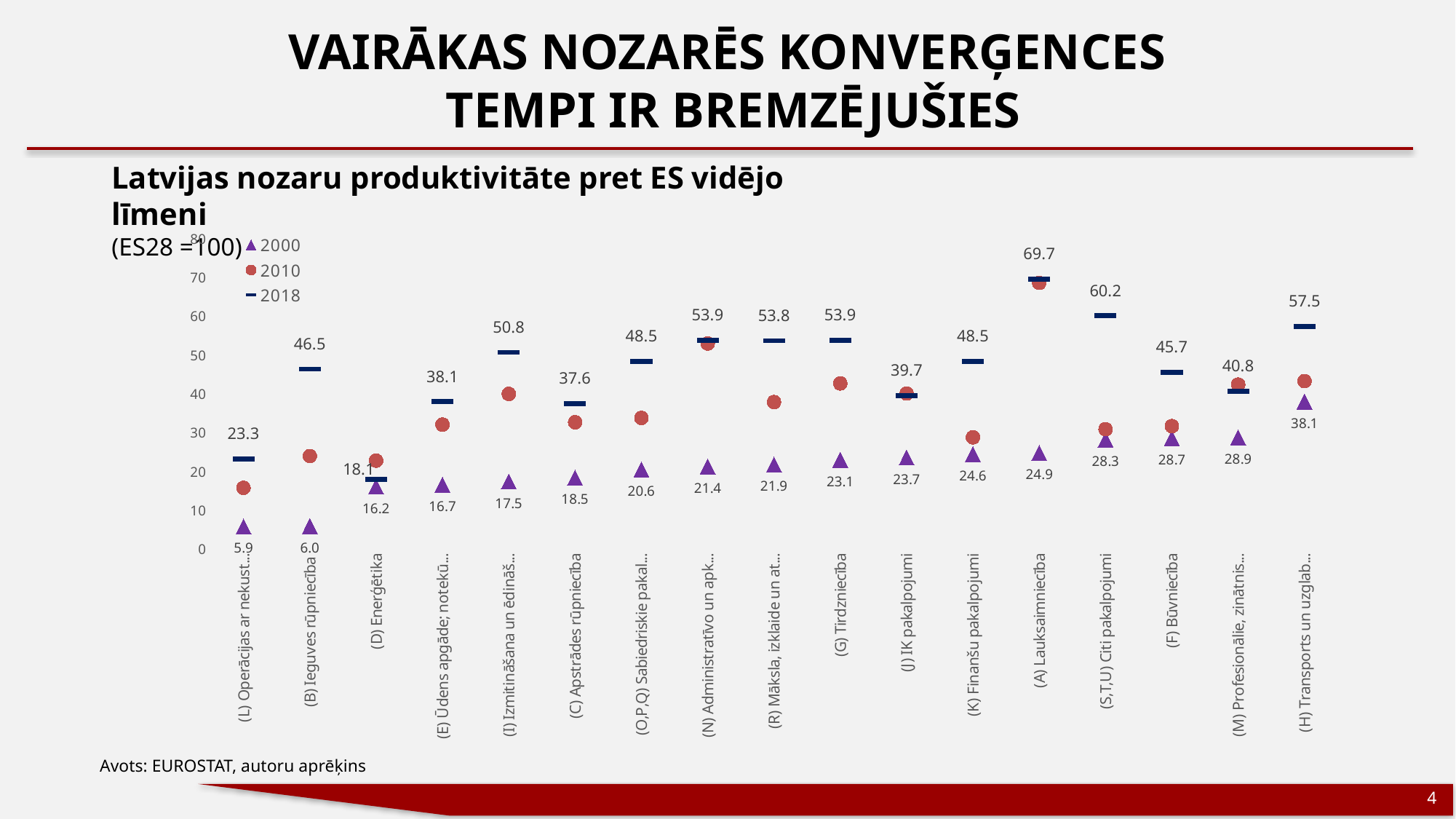
What is the 2018 value for (A) Lauksaimniecība? 69.7 Which sector has the highest 2018 value? (A) Lauksaimniecība What is the lowest 2000 value shown on the chart? 5.9 Is the 2010 value for (A) Lauksaimniecība greater or less than 60? greater Do the 2000 values rise or fall moving from left to right along the x axis? rise What is the 2018 value for (S,T,U) Citi pakalpojumi? 60.2 What is the 2000 value for (D) Enerģētika? 16.2 How many sectors (categories) are plotted along the x axis? 17 How many series does the legend list? 3 What is the difference between the 2018 and 2000 values for (H) Transports un uzglab...? 19.4 Which has the larger 2018 value: (B) Ieguves rūpniecība or (F) Būvniecība? (B) Ieguves rūpniecība What kind of chart is shown on the slide? scatter chart